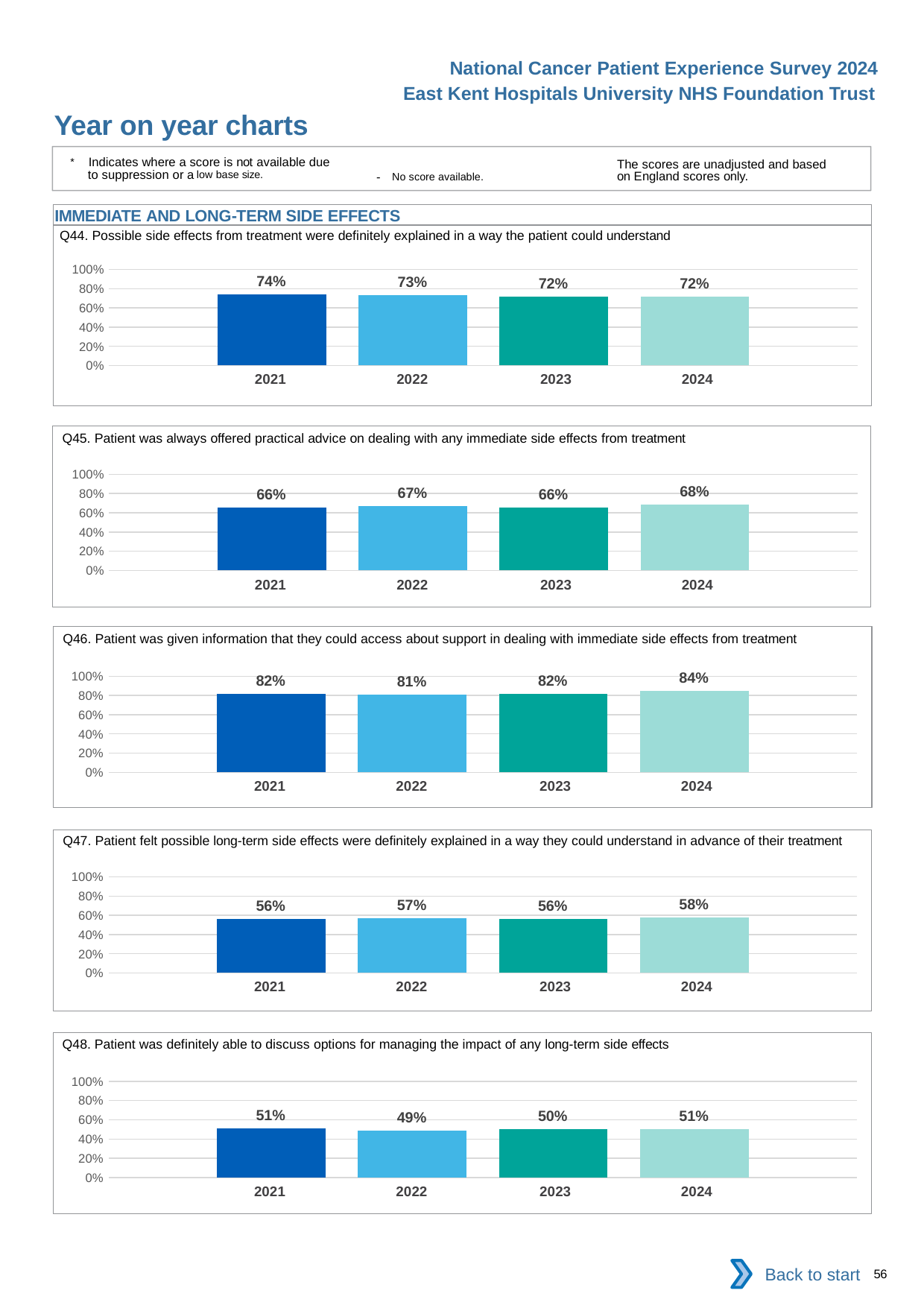
In the Q45 chart, what is the value for 2024? 68% In the Q45 chart, what is the difference between the 2024 and 2021 values? 2 percentage points In the Q46 chart, which year has the lowest value? 2022 How many years are shown in the Q48 chart? 4 In the Q47 chart, which is larger, the value for 2022 or the value for 2023? 2022 In the Q44 chart, which year has the highest value? 2021 In the Q46 chart, what is the value for 2024? 84% In the Q44 chart, what is the value for 2021? 74% In the Q48 chart, what is the value for 2022? 49% In the Q48 chart, what is the difference between the 2021 and 2022 values? 2 percentage points What type of chart is the Q44 chart? Bar chart In the Q47 chart, is the value for 2024 greater or less than 60%? less